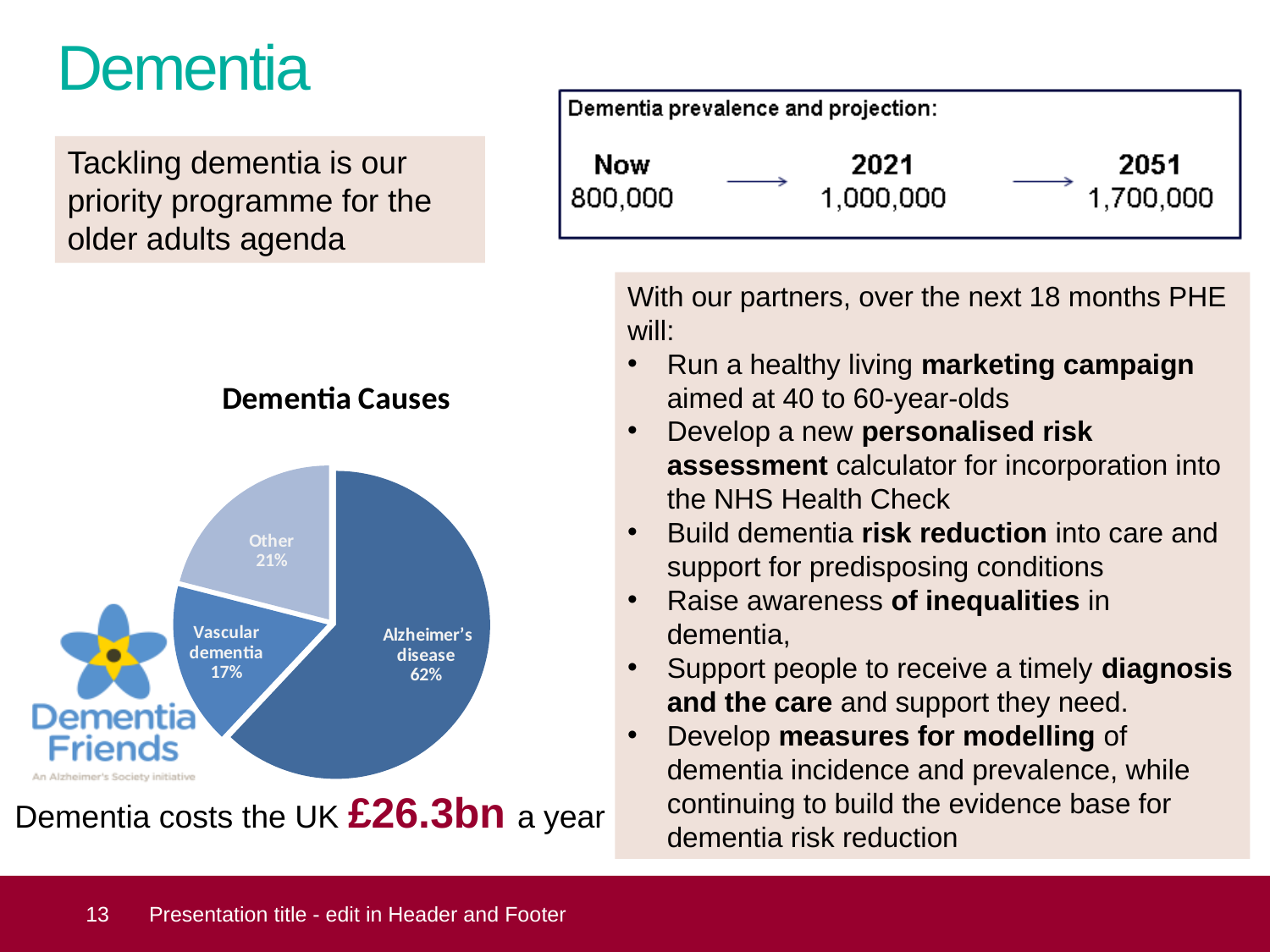
In the Dementia Causes pie chart, what is the difference in percentage points between Other and Vascular dementia? 4 In the Dementia Causes pie chart, what share is attributed to Vascular dementia? 17% In the Dementia Causes pie chart, what share is attributed to Alzheimer's disease? 62% How many slices does the Dementia Causes pie chart have? 3 In the Dementia Causes pie chart, is the Alzheimer's disease share greater or less than 50%? greater In the Dementia Causes pie chart, what share is attributed to Other? 21% In the Dementia Causes pie chart, what is the difference in percentage points between Alzheimer's disease and Other? 41 What kind of chart is the Dementia Causes chart? pie chart In the Dementia Causes pie chart, which is larger: Other or Vascular dementia? Other What is the title of the pie chart on the slide? Dementia Causes Which slice of the Dementia Causes pie chart is the smallest? Vascular dementia Which slice of the Dementia Causes pie chart is the largest? Alzheimer's disease